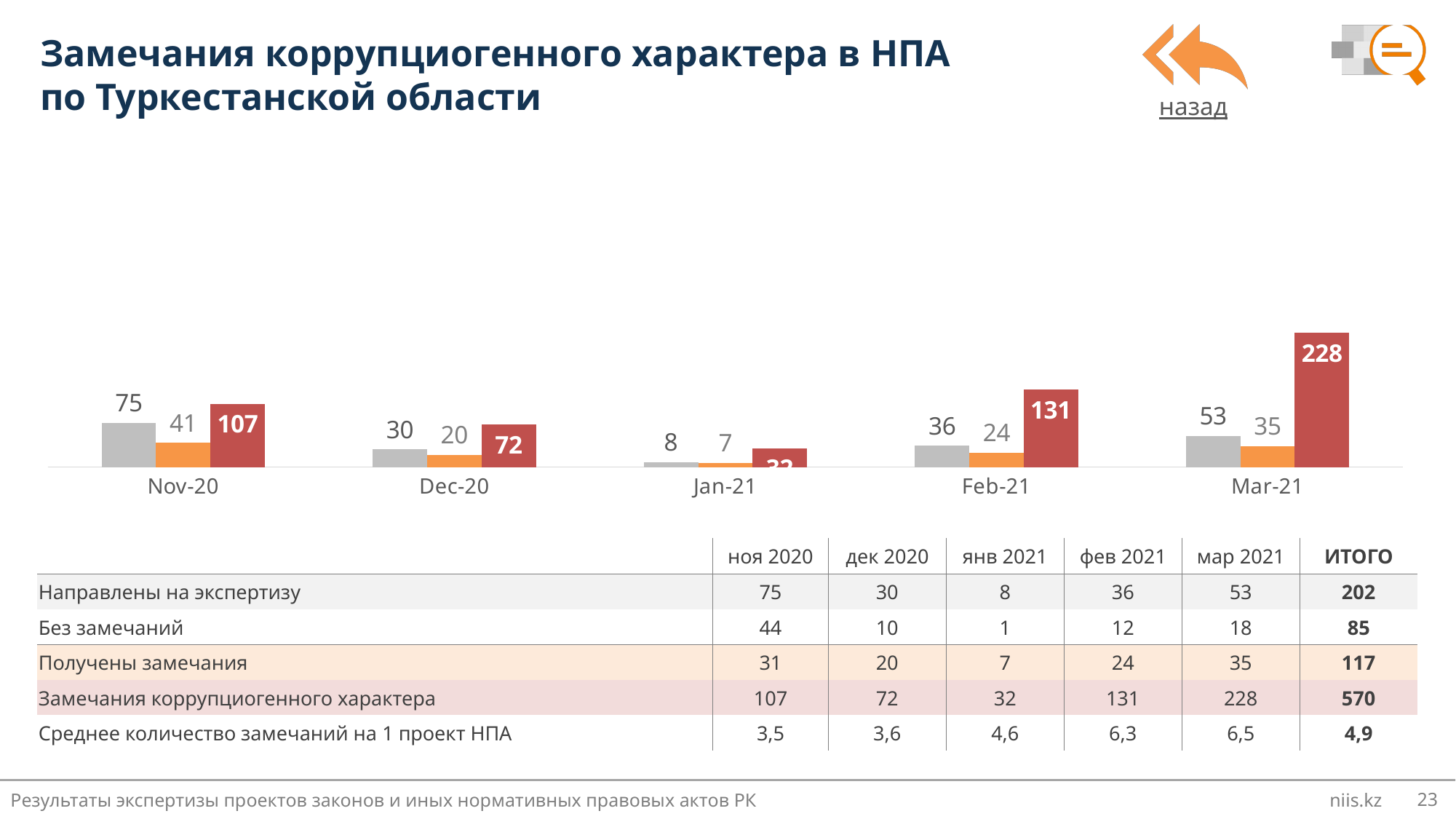
What is the value of the orange bar for Feb-21? 24 Which month has the lowest grey bar? Jan-21 How many months are shown on the x axis of the chart? 5 What is the value of the red bar for Dec-20? 72 What is the difference between the red bar values for Mar-21 and Feb-21? 97 What is the value of the grey bar for Nov-20? 75 Which month has the highest red bar? Mar-21 Which is larger, the red bar for Nov-20 or the red bar for Dec-20? Nov-20 What kind of chart is shown on the slide? Bar chart Do the red bar values rise or fall from Jan-21 to Mar-21? Rise What is the difference between the grey bar values for Nov-20 and Dec-20? 45 What is the value of the red bar for Mar-21? 228